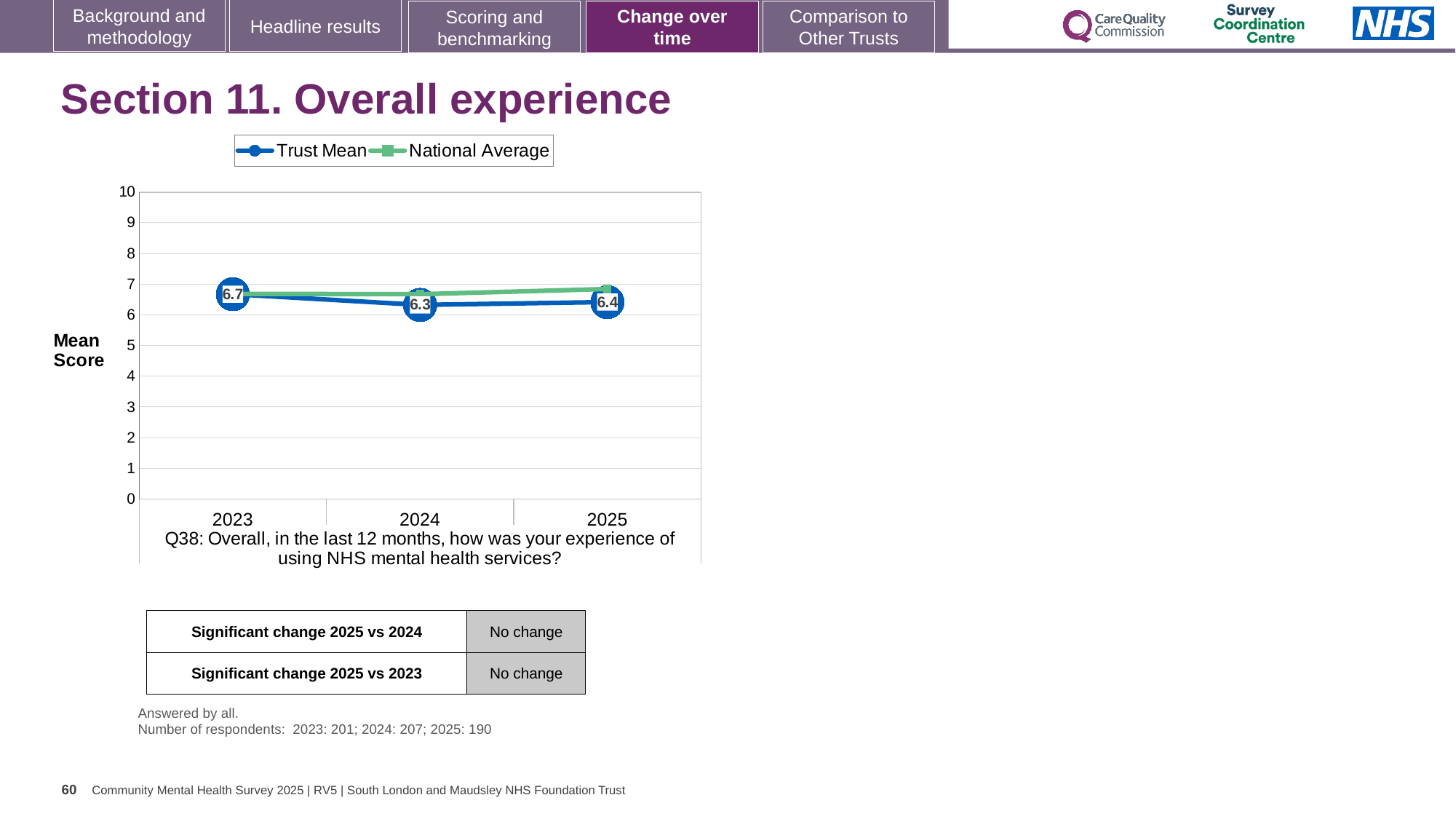
In which year is the Trust Mean highest? 2023 Is the National Average value for 2025 greater or less than 6? greater What kind of chart is shown on the slide? Line chart What is the Trust Mean score for 2024? 6.3 In which year is the Trust Mean lowest? 2024 Which year has the larger Trust Mean, 2024 or 2025? 2025 How many years are plotted on the x axis? 3 What is the Trust Mean score for 2025? 6.4 What is the difference between the Trust Mean in 2023 and in 2024? 0.4 Does the Trust Mean rise or fall from 2023 to 2024? Fall How many series does the legend list? 2 What is the Trust Mean score for 2023? 6.7